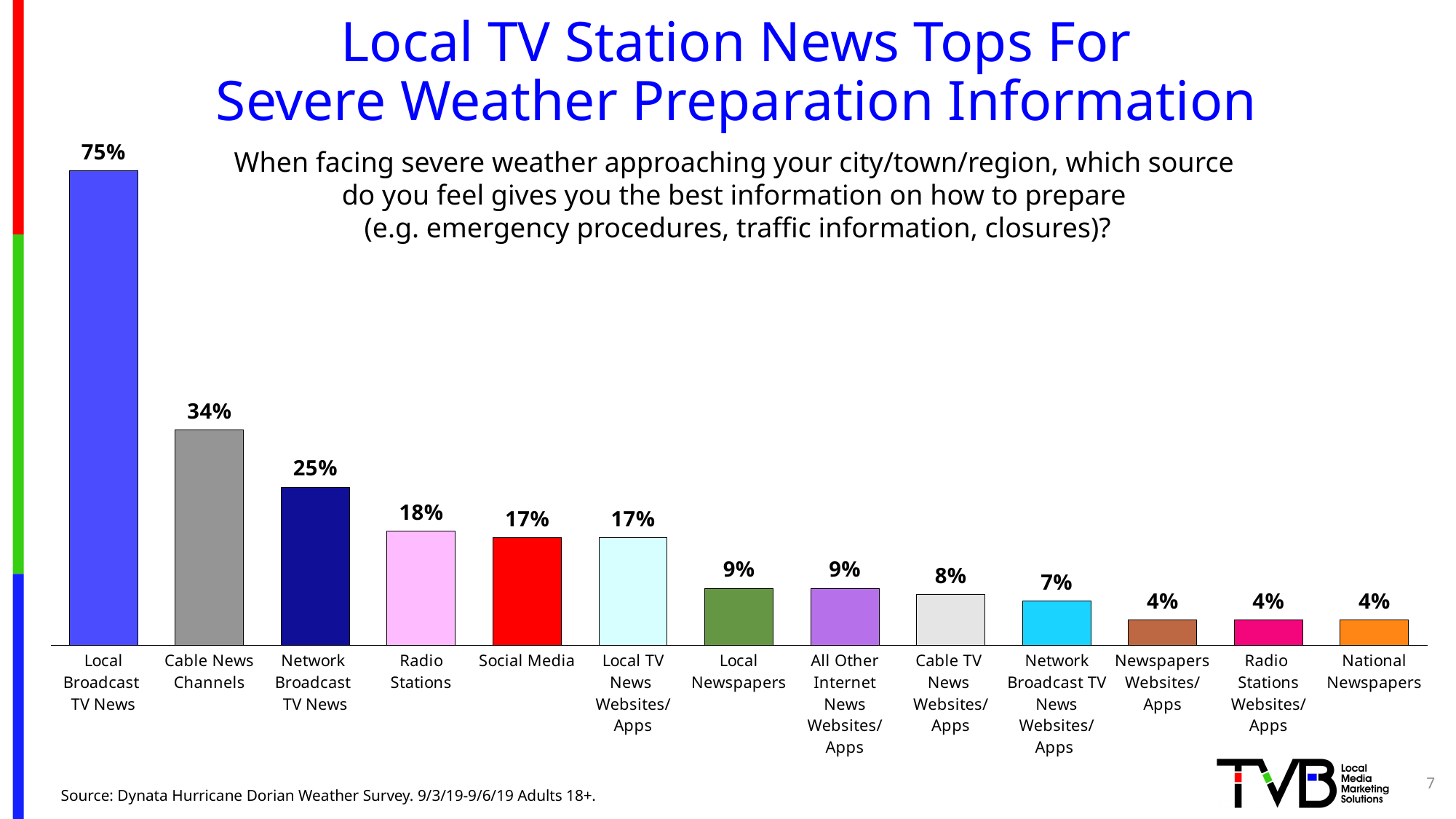
Do the values rise or fall from left to right across the chart? Fall What percentage is shown for Local Broadcast TV News? 75% What is the difference between Local Broadcast TV News and Cable News Channels? 41% What percentage is shown for Radio Stations? 18% Which is larger, Local Newspapers or Cable TV News Websites/Apps? Local Newspapers What is the difference between Network Broadcast TV News and Radio Stations? 7% What percentage is shown for Cable News Channels? 34% What kind of chart is shown on the slide? Bar chart How many sources are shown in the chart? 13 Which is larger, Cable News Channels or Network Broadcast TV News? Cable News Channels What percentage is shown for Network Broadcast TV News Websites/Apps? 7% Which source has the highest percentage? Local Broadcast TV News